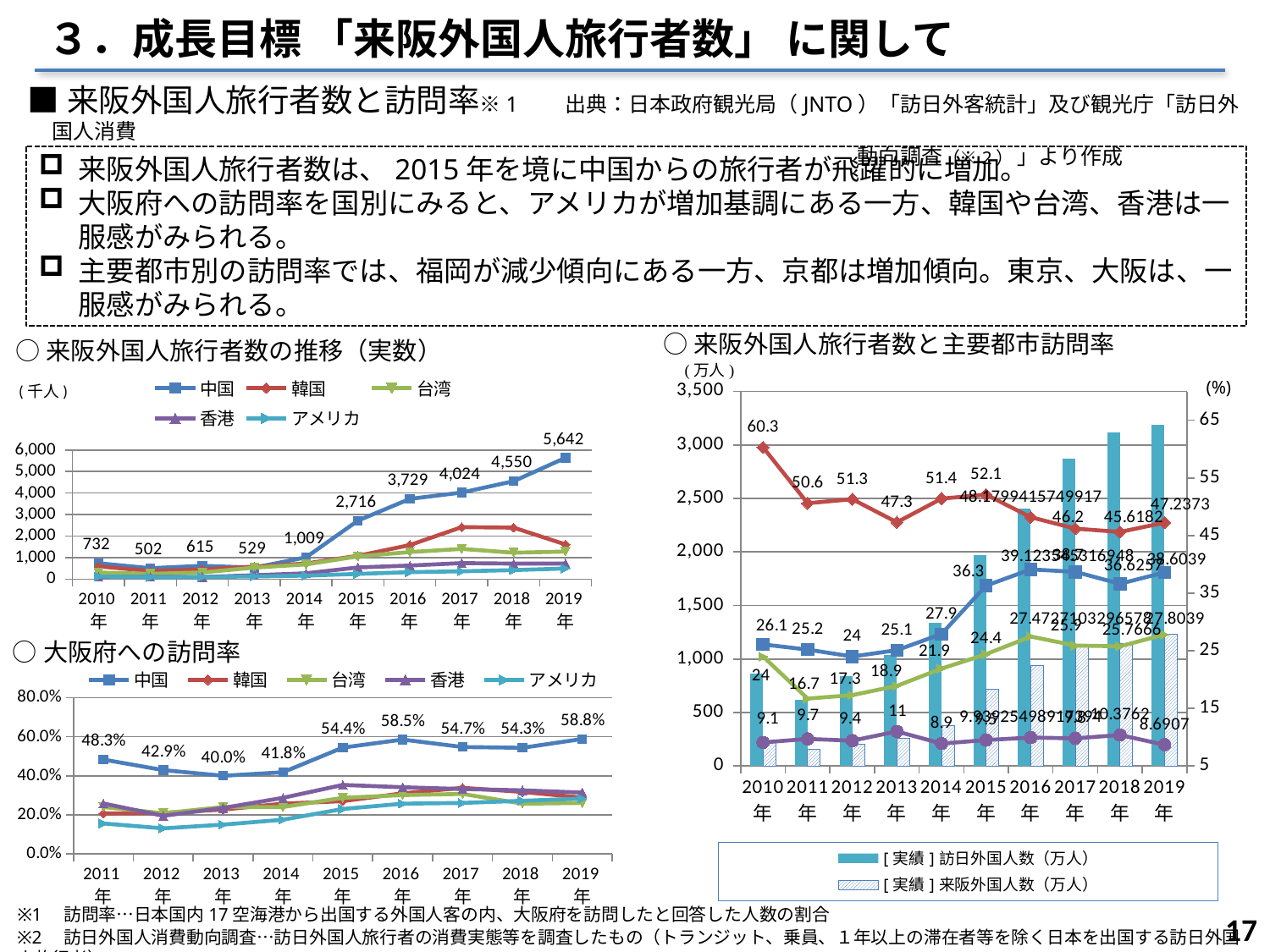
In the chart titled 来阪外国人旅行者数の推移（実数）, how many years are shown on the x axis? 10 In the chart titled 来阪外国人旅行者数の推移（実数）, what is the value for 中国 in 2015年? 2,716 In the chart titled 来阪外国人旅行者数の推移（実数）, in which year is the value for 中国 the lowest? 2011年 What kind of chart is the chart titled 大阪府への訪問率? Line chart In the chart titled 大阪府への訪問率, which is larger for 中国: the value in 2015年 or the value in 2016年? 2016年 In the chart titled 来阪外国人旅行者数の推移（実数）, how many series does the legend list? 5 In the chart titled 大阪府への訪問率, what is the difference between the 中国 values for 2016年 and 2013年? 18.5% In the chart titled 大阪府への訪問率, in which year is the value for 中国 the lowest? 2013年 In the chart titled 大阪府への訪問率, what is the value for 中国 in 2019年? 58.8% In the chart titled 来阪外国人旅行者数の推移（実数）, what is the difference between the 中国 values for 2019年 and 2018年? 1,092 In the chart titled 来阪外国人旅行者数と主要都市訪問率, is the 訪日外国人数 bar for 2019年 greater or less than 3,000? greater In the chart titled 来阪外国人旅行者数の推移（実数）, what is the value for 中国 in 2019年? 5,642